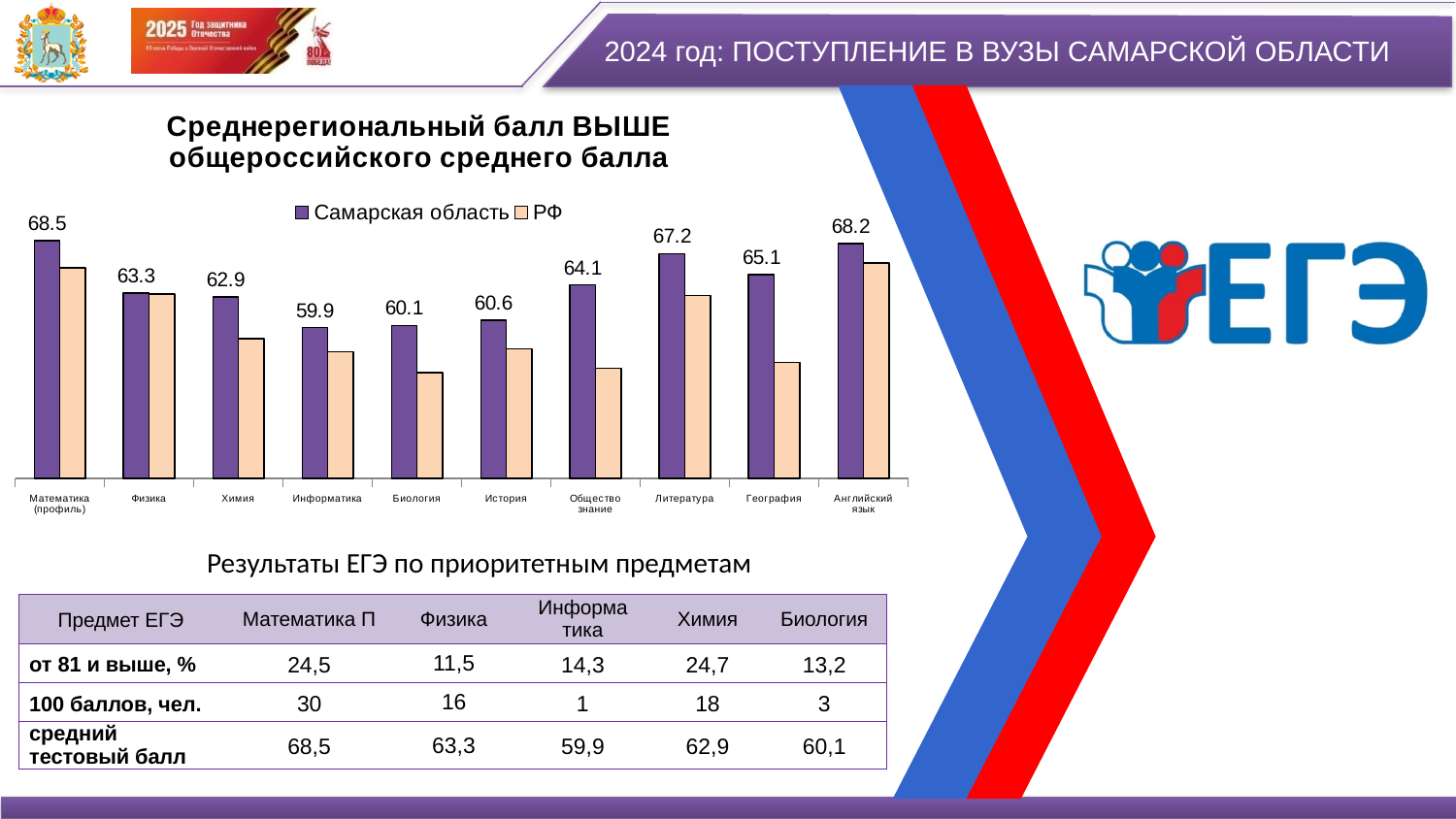
Which subject has the lowest value for Самарская область on the chart? Информатика Which subject has the highest value for Самарская область on the chart? Математика (профиль) How many subject categories are shown on the chart's x axis? 10 What is the value for Самарская область for Математика (профиль) on the chart? 68.5 What is the value for Самарская область for Информатика on the chart? 59.9 What is the value for Самарская область for Литература on the chart? 67.2 Which is larger for Самарская область: the value for География or the value for Обществознание? География What is the difference between the Самарская область values for Математика (профиль) and Физика? 5.2 For Химия, which series has the larger value: Самарская область or РФ? Самарская область What type of chart is shown on the slide? bar chart What are the two series named in the chart legend? Самарская область and РФ How many series does the chart legend list? 2